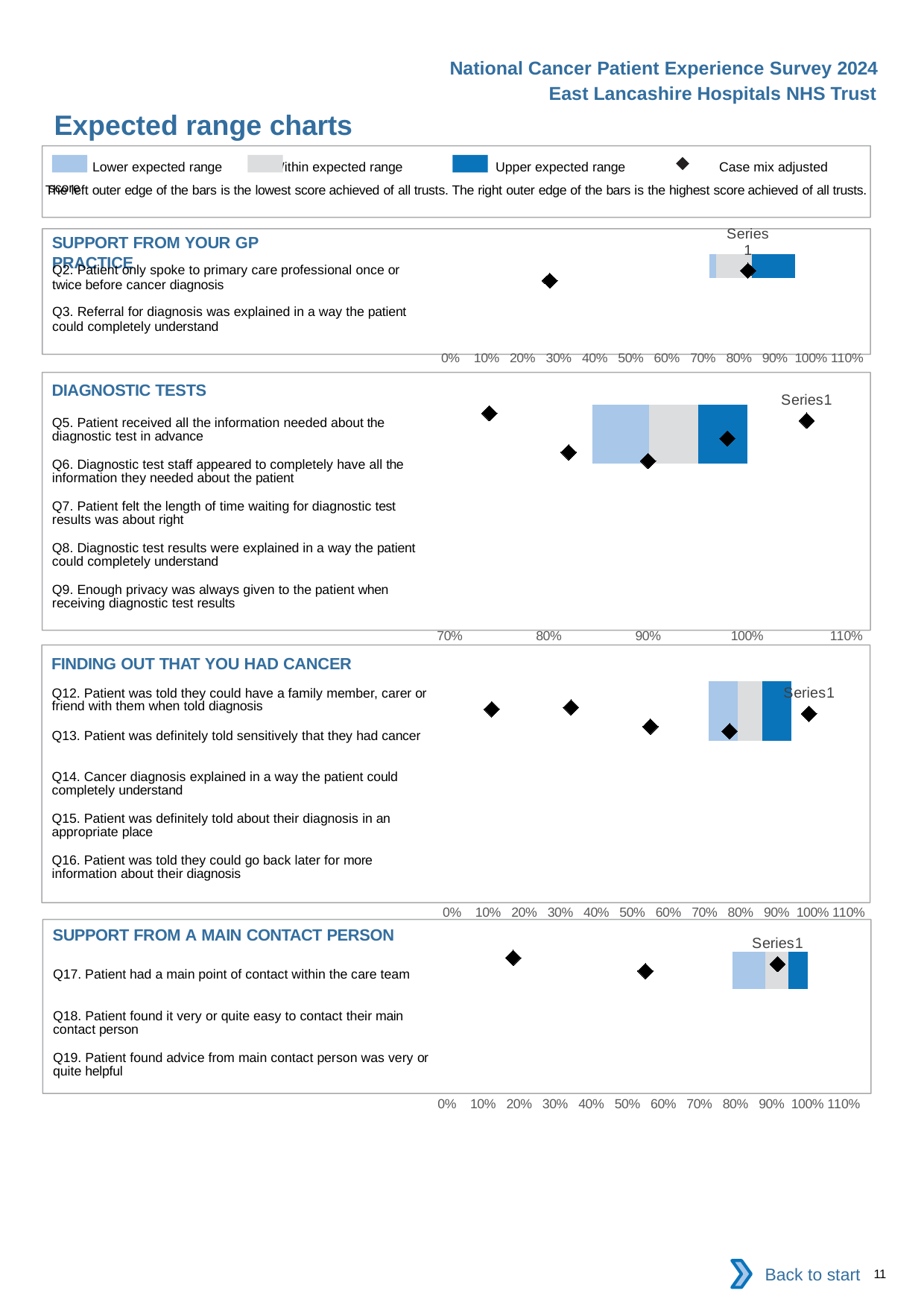
How many questions are listed in the 'FINDING OUT THAT YOU HAD CANCER' chart? 5 What kind of chart is used in the 'DIAGNOSTIC TESTS' section? bar chart How many questions are listed in the 'SUPPORT FROM A MAIN CONTACT PERSON' chart? 3 In the 'DIAGNOSTIC TESTS' chart, is the leftmost diamond marker greater or less than 80%? less In the 'FINDING OUT THAT YOU HAD CANCER' chart, is the leftmost diamond marker greater or less than 20%? less How many entries does the legend at the top of the slide list? 4 How many questions are listed in the 'SUPPORT FROM YOUR GP PRACTICE' chart? 2 In the legend at the top of the slide, what does the diamond marker represent? Case mix adjusted score In the 'FINDING OUT THAT YOU HAD CANCER' chart, is the rightmost diamond marker greater or less than 90%? greater In the 'DIAGNOSTIC TESTS' chart, what is the lowest value shown on the x axis? 70%